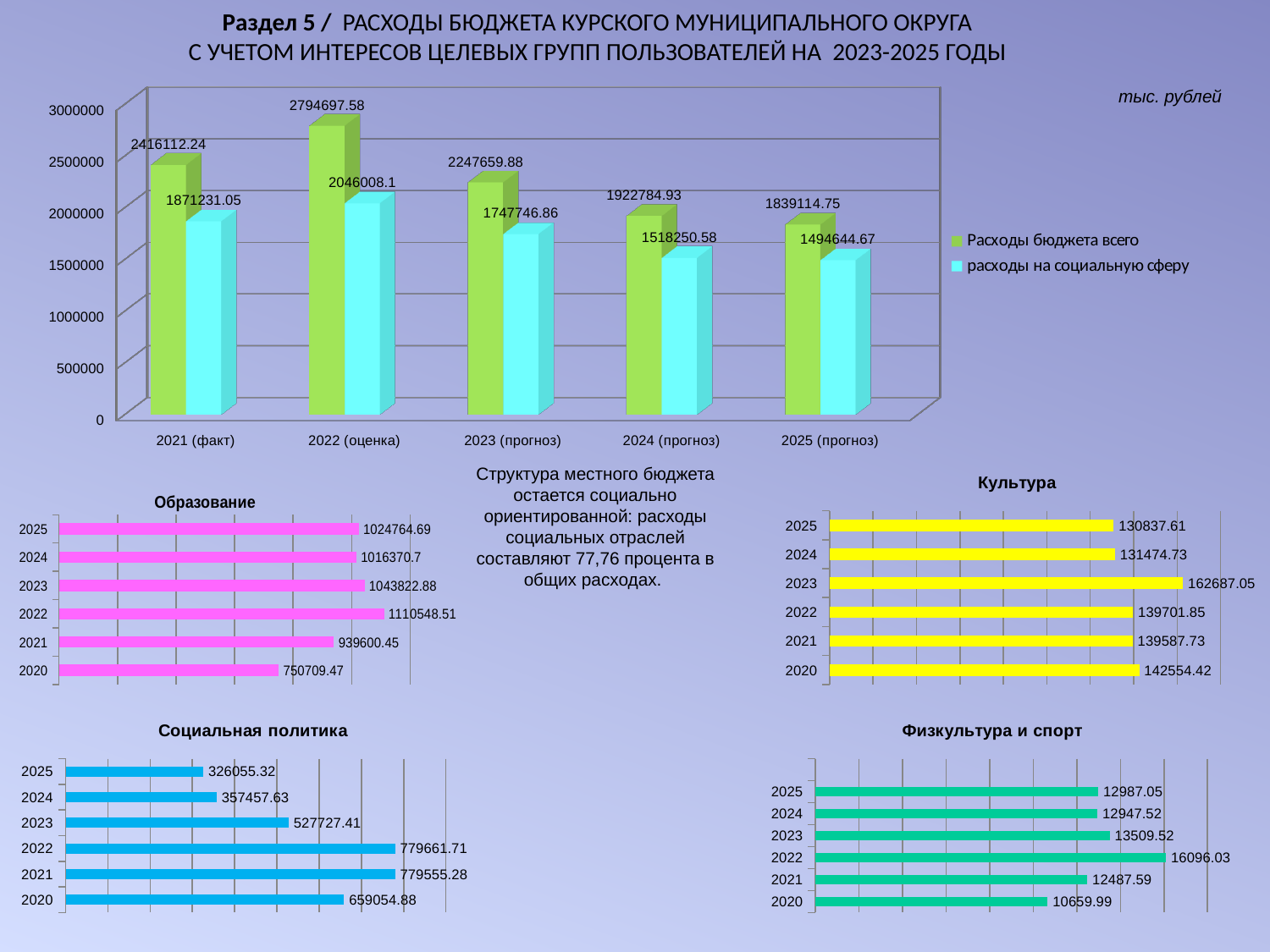
In the top chart, what is the value of 'Расходы бюджета всего' for 2022 (оценка)? 2794697.58 How many series does the legend of the top chart list? 2 In the 'Образование' chart, which year has the lowest value? 2020 In the top chart, what is the value of 'расходы на социальную сферу' for 2025 (прогноз)? 1494644.67 In the 'Физкультура и спорт' chart, what is the difference between the values for 2022 and 2020? 5436.04 In the 'Культура' chart, which year has the highest value? 2023 In the 'Социальная политика' chart, what is the value for 2023? 527727.41 What kind of chart is the 'Социальная политика' chart? bar chart In the 'Образование' chart, what is the value for 2022? 1110548.51 In the top chart, what is the difference between 'Расходы бюджета всего' and 'расходы на социальную сферу' for 2022 (оценка)? 748689.48 In the top chart, do the values for 'Расходы бюджета всего' rise or fall from 2022 (оценка) to 2025 (прогноз)? fall In the top chart, which year has the highest value for 'Расходы бюджета всего'? 2022 (оценка)